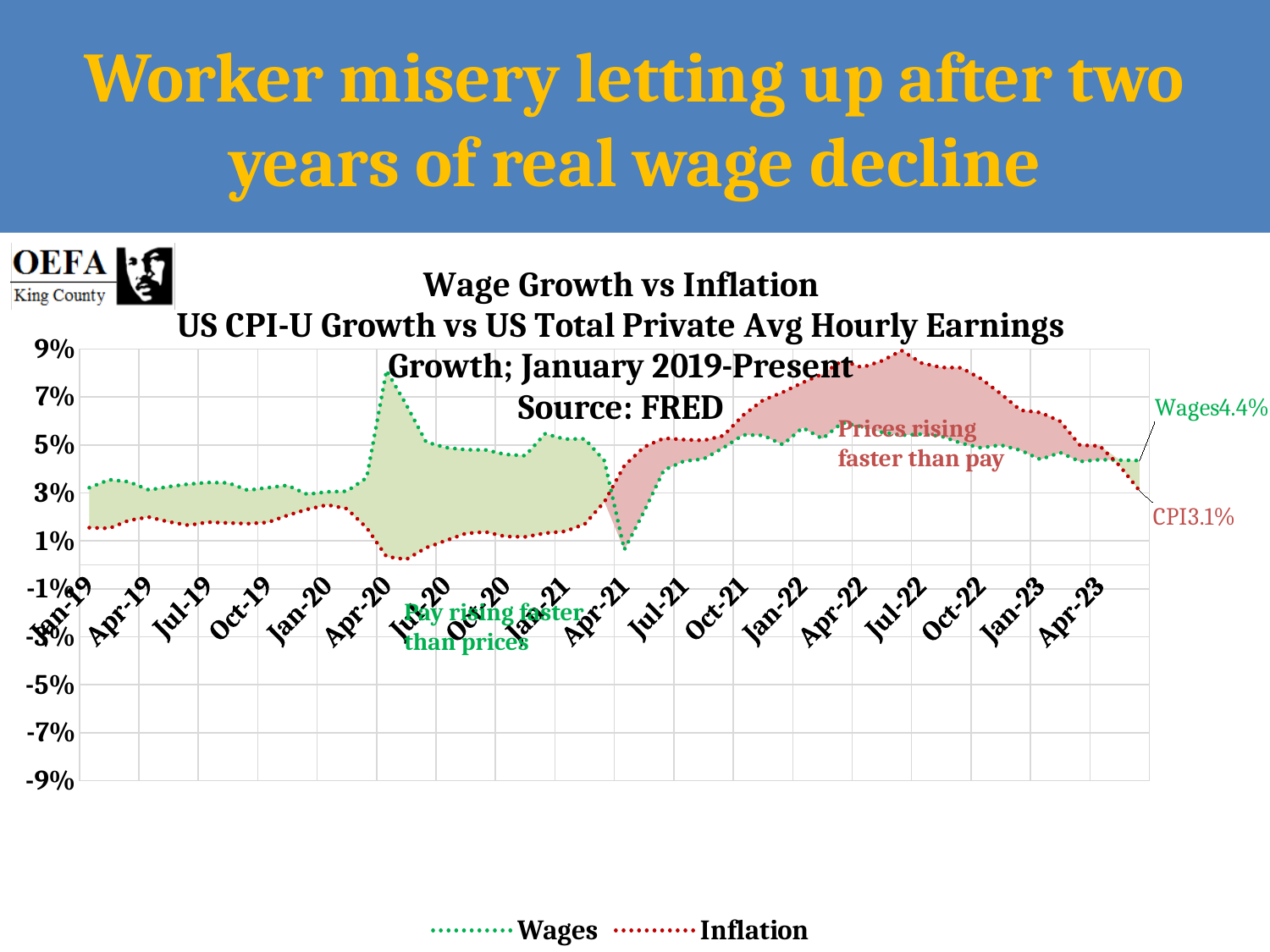
What source is cited in the chart title? FRED Is the Inflation value around Jul-22 greater or less than 7%? greater What is the difference between the latest Wages value (4.4%) and the latest CPI value (3.1%)? 1.3% What kind of chart is shown on the slide? Line chart How many series does the legend list? 2 At the end of the chart, which is higher: Wages or CPI? Wages Is the Wages value around Apr-20 greater or less than 5%? greater Is the Inflation value at Jan-19 greater or less than 3%? less Which series reaches the highest point anywhere on the chart? Inflation What is the latest value shown for CPI (inflation) on the chart? 3.1% What is the latest value shown for Wages on the chart? 4.4% Does the Inflation line rise or fall from Jul-22 to Apr-23? Fall